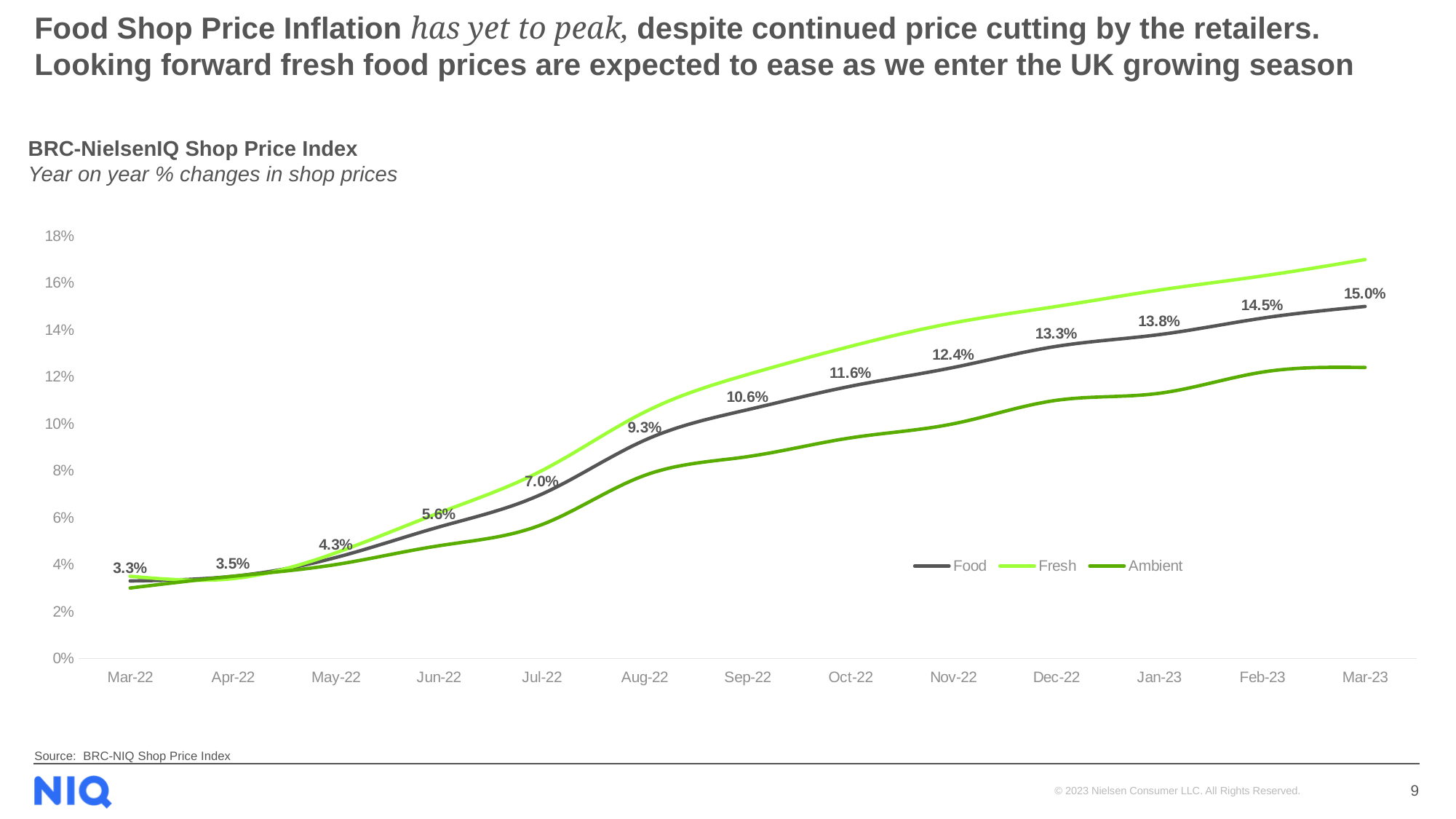
What is the Food value for Aug-22? 9.3% In which month is the Food series at its lowest? Mar-22 Is the Ambient value for Mar-23 greater or less than 14%? less Which is larger, the Food value for Dec-22 or the Food value for Nov-22? Dec-22 How many months are shown on the x axis? 13 In which month is the Food series at its highest? Mar-23 What kind of chart is this? Line chart What is the difference between the Food values for Mar-23 and Mar-22? 11.7% Is the Fresh value for Mar-23 greater or less than 16%? greater What is the Food value for Mar-22? 3.3% What is the Food value for Mar-23? 15.0% How many series does the legend list? 3